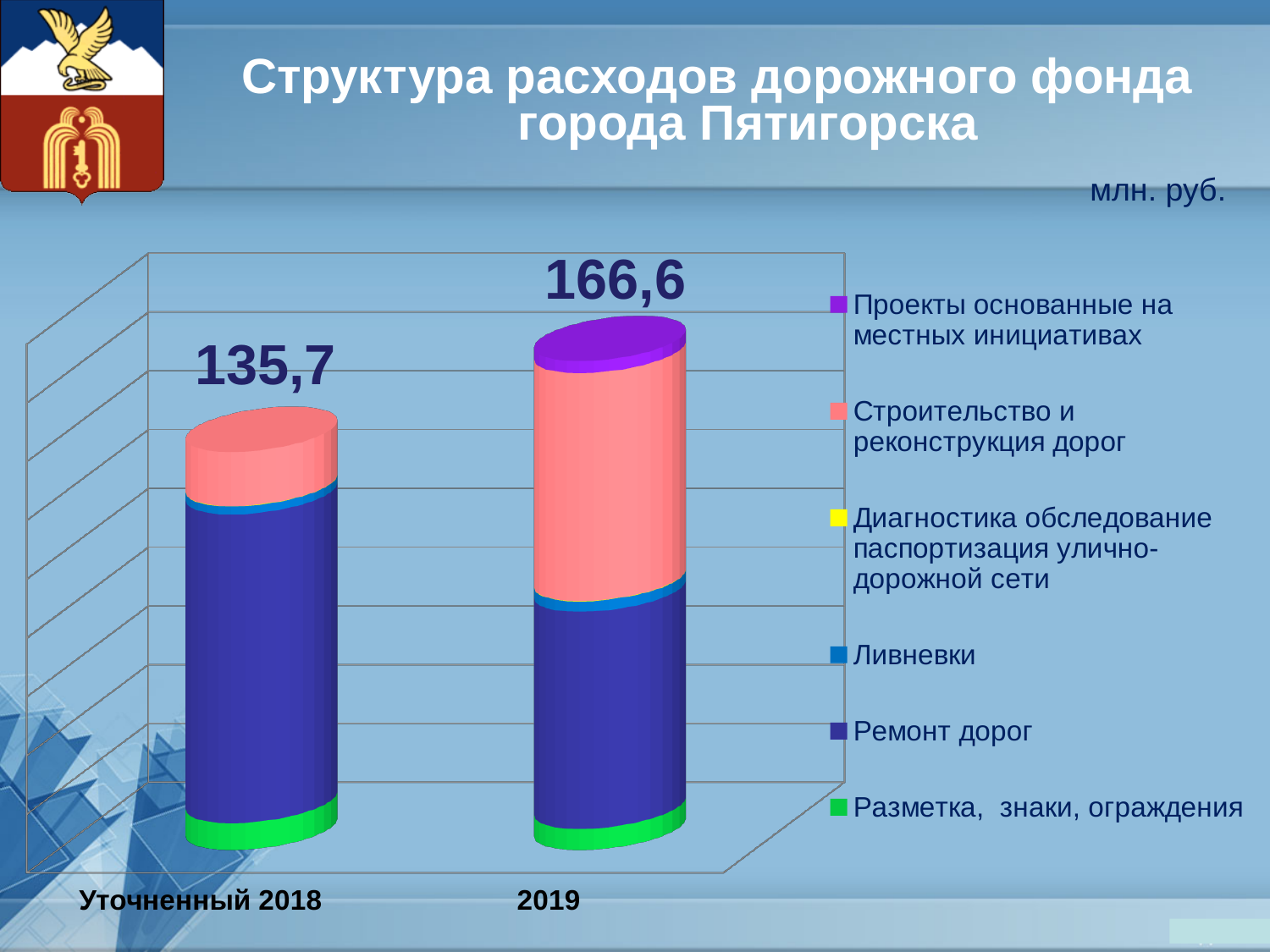
How many categories are shown on the x axis? 2 Which category has the lower total? Уточненный 2018 Which category has the higher total, Уточненный 2018 or 2019? 2019 What is the total value shown for 2019? 166,6 Which legend entry is shown in purple? Проекты основанные на местных инициативах Is the total for 2019 larger or smaller than the total for Уточненный 2018? larger Do the totals rise or fall from Уточненный 2018 to 2019? rise What kind of chart is shown on the slide? stacked bar chart What unit is stated for the values on the chart? млн. руб. What is the total value shown for Уточненный 2018? 135,7 How many series does the legend list? 6 What is the difference between the 2019 total and the Уточненный 2018 total? 30,9